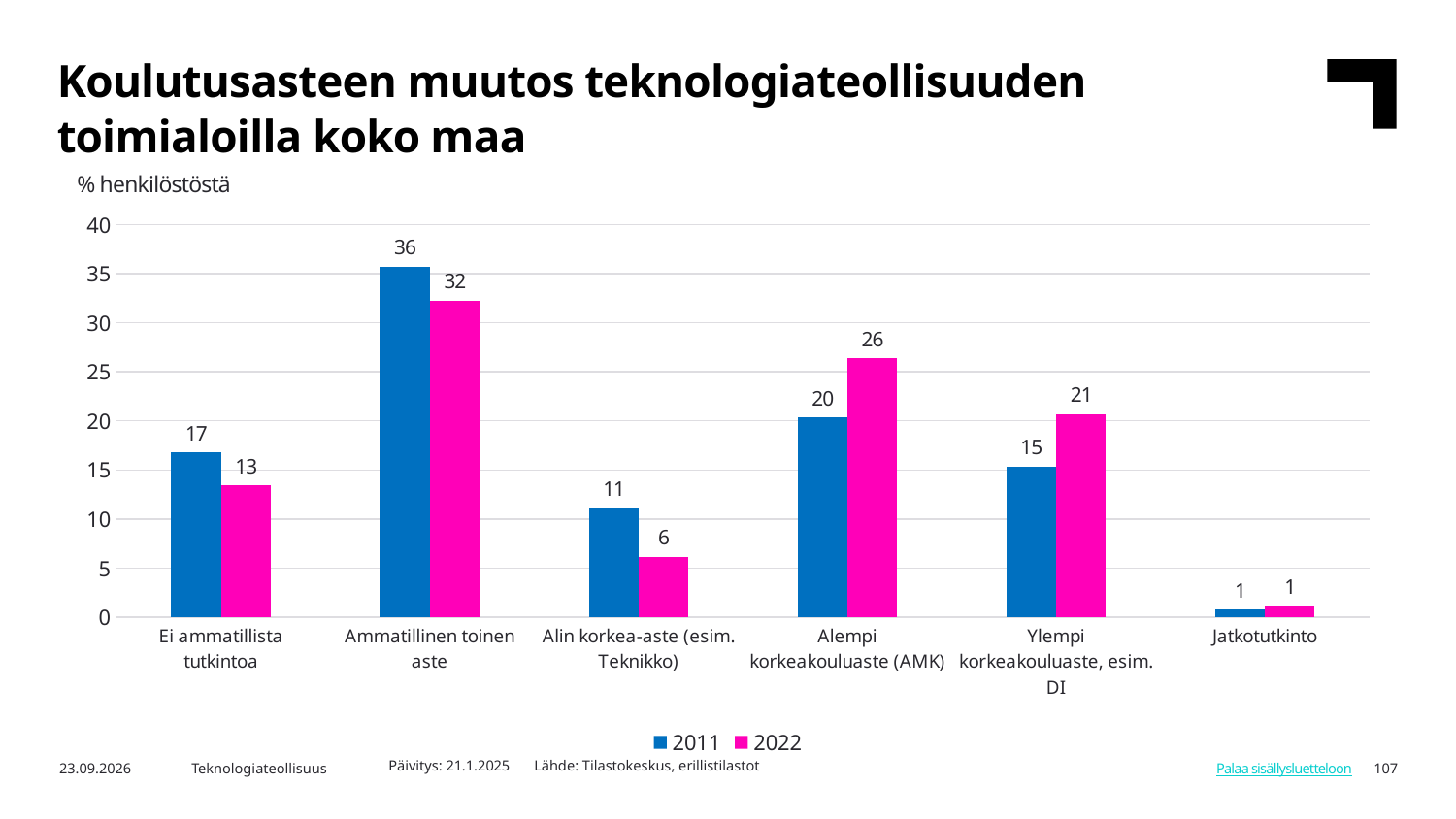
What is the title of the chart? Koulutusasteen muutos teknologiateollisuuden toimialoilla koko maa How many series does the legend list? 2 What is the difference between the 2011 and 2022 values for 'Ei ammatillista tutkintoa'? 4 What is the value for 2011 in the 'Ammatillinen toinen aste' category? 36 What is the value for 2022 in the 'Alempi korkeakouluaste (AMK)' category? 26 What is the value for 2022 in the 'Alin korkea-aste (esim. Teknikko)' category? 6 Which category has the lowest value for 2022? Jatkotutkinto Which is larger for 'Ylempi korkeakouluaste, esim. DI': the 2011 value or the 2022 value? 2022 How many categories are shown on the x axis? 6 Which category has the highest value for 2011? Ammatillinen toinen aste What kind of chart is shown on the slide? Bar chart Is the value for 2022 in 'Ammatillinen toinen aste' greater or less than 30? greater